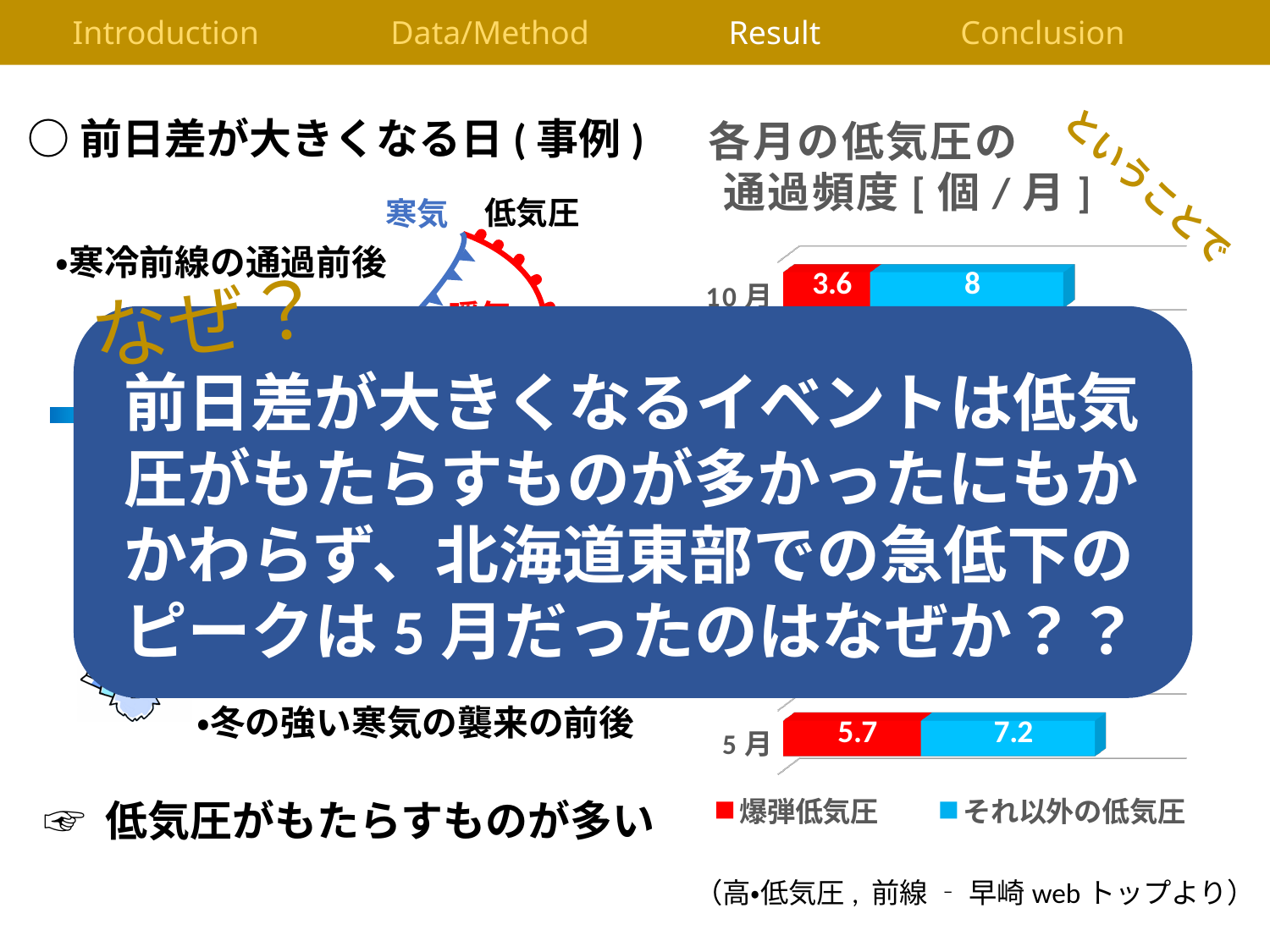
In the chart 各月の低気圧の通過頻度, what is the total of the stacked bar for 5月? 12.9 In the chart 各月の低気圧の通過頻度, what is the difference between the 爆弾低気圧 values for 5月 and 10月? 2.1 In the chart 各月の低気圧の通過頻度, which month has the larger それ以外の低気圧 value, 10月 or 5月? 10月 In the chart 各月の低気圧の通過頻度, what is the value of 爆弾低気圧 for 5月? 5.7 How many series does the legend of the chart 各月の低気圧の通過頻度 list? 2 In the chart 各月の低気圧の通過頻度, what is the total of the stacked bar for 10月? 11.6 In the chart 各月の低気圧の通過頻度, what is the value of それ以外の低気圧 for 5月? 7.2 In the chart 各月の低気圧の通過頻度, what is the value of それ以外の低気圧 for 10月? 8 What kind of chart is 各月の低気圧の通過頻度? Stacked bar chart In the chart 各月の低気圧の通過頻度, what is the value of 爆弾低気圧 for 10月? 3.6 In the chart 各月の低気圧の通過頻度, which colour represents 爆弾低気圧? Red In the chart 各月の低気圧の通過頻度, which month has the larger 爆弾低気圧 value, 10月 or 5月? 5月